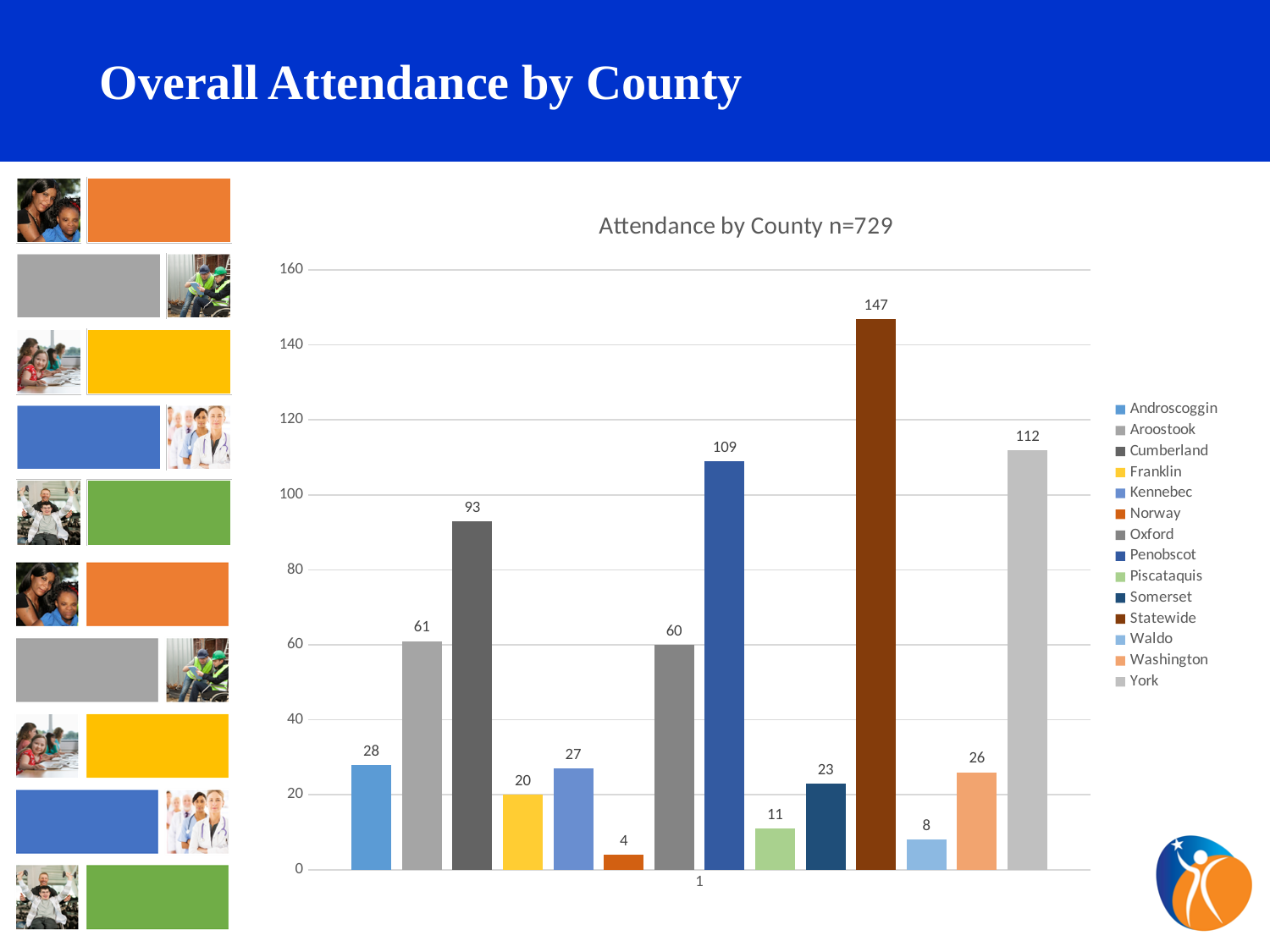
What is the attendance value for Waldo? 8 What kind of chart is shown on the slide? bar chart What is the attendance value for Penobscot? 109 What is the difference between the attendance values for Statewide and York? 35 Which series has the lowest attendance value? Norway Is the value for York greater or less than 100? greater What is the title of the chart? Attendance by County n=729 What is the difference between the attendance values for Aroostook and Oxford? 1 What is the attendance value for Cumberland? 93 Which has a larger attendance value, Androscoggin or Kennebec? Androscoggin Which series has the highest attendance value? Statewide How many series does the legend list? 14